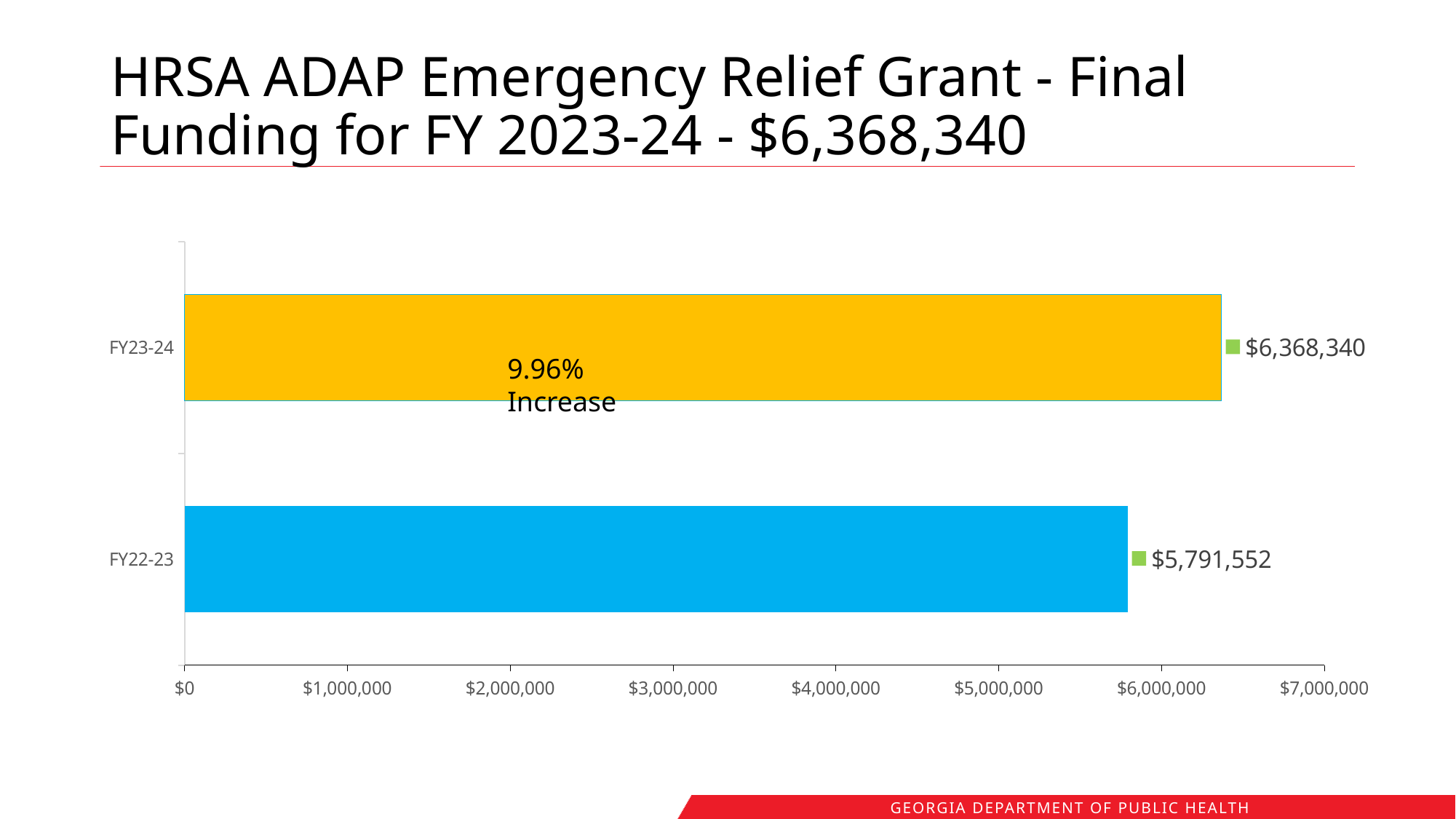
What kind of chart is shown on the slide? bar chart Which fiscal year has the highest value? FY23-24 Is the value for FY22-23 greater or less than $6,000,000? less What colour is the FY23-24 bar? yellow Is the value for FY23-24 greater or less than $6,000,000? greater What is the value for FY22-23? $5,791,552 What is the difference between the FY23-24 and FY22-23 values? $576,788 What is the value for FY23-24? $6,368,340 Which fiscal year has the lowest value? FY22-23 What percentage increase is annotated on the FY23-24 bar? 9.96% How many fiscal years are shown in the chart? 2 Which is larger, the value for FY23-24 or FY22-23? FY23-24